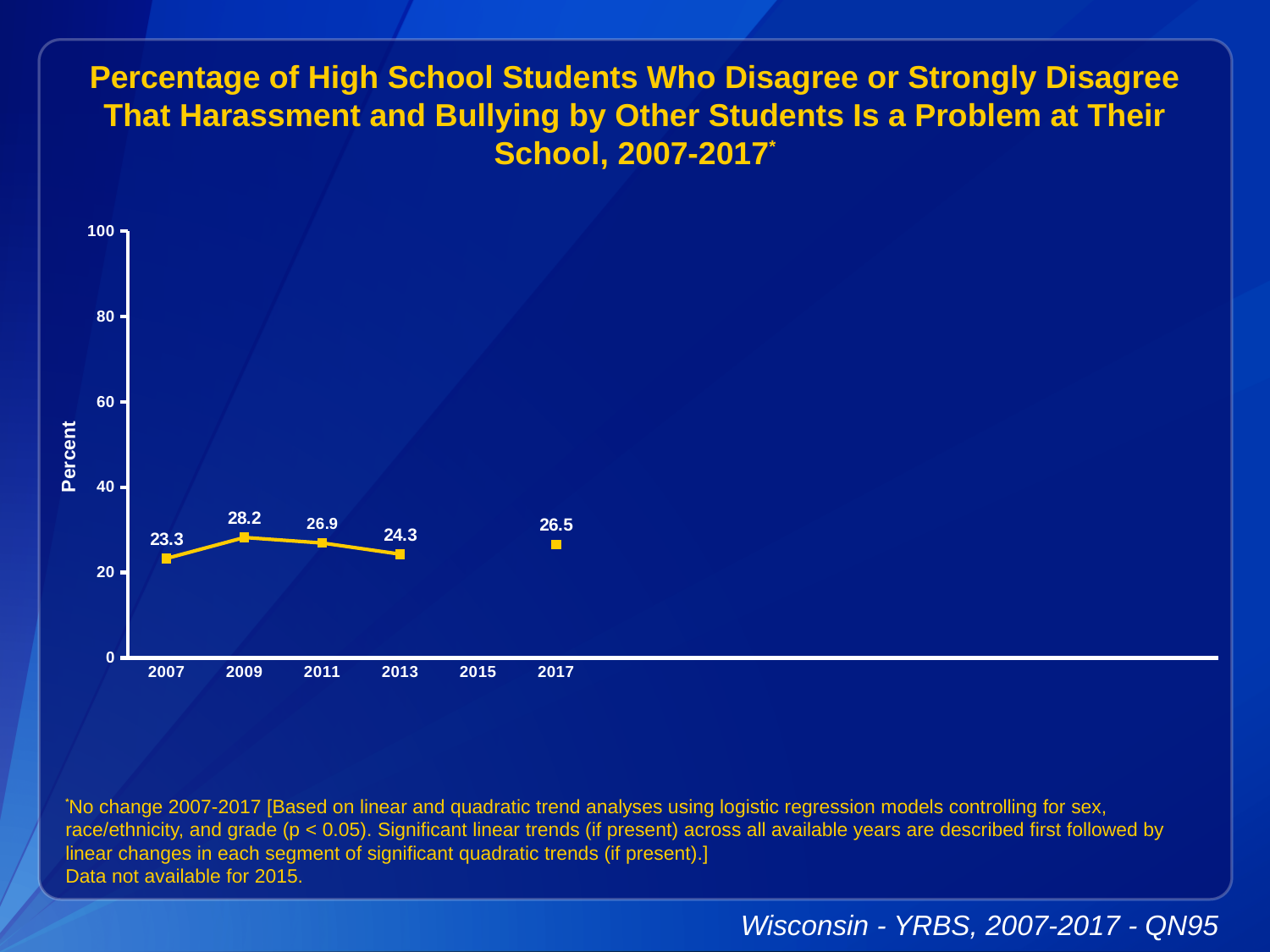
What is the difference between the values for 2009 and 2007? 4.9 Is the value for 2009 greater or less than 40? less Which year on the x axis has no data plotted? 2015 What is the value for 2013? 24.3 Which year has the lowest value? 2007 How many years have a plotted data point? 5 What is the value for 2017? 26.5 What is the value for 2007? 23.3 Which is larger, the value for 2011 or the value for 2013? 2011 Do the values rise or fall from 2009 to 2013? fall Which year has the highest value? 2009 What kind of chart is this? line chart